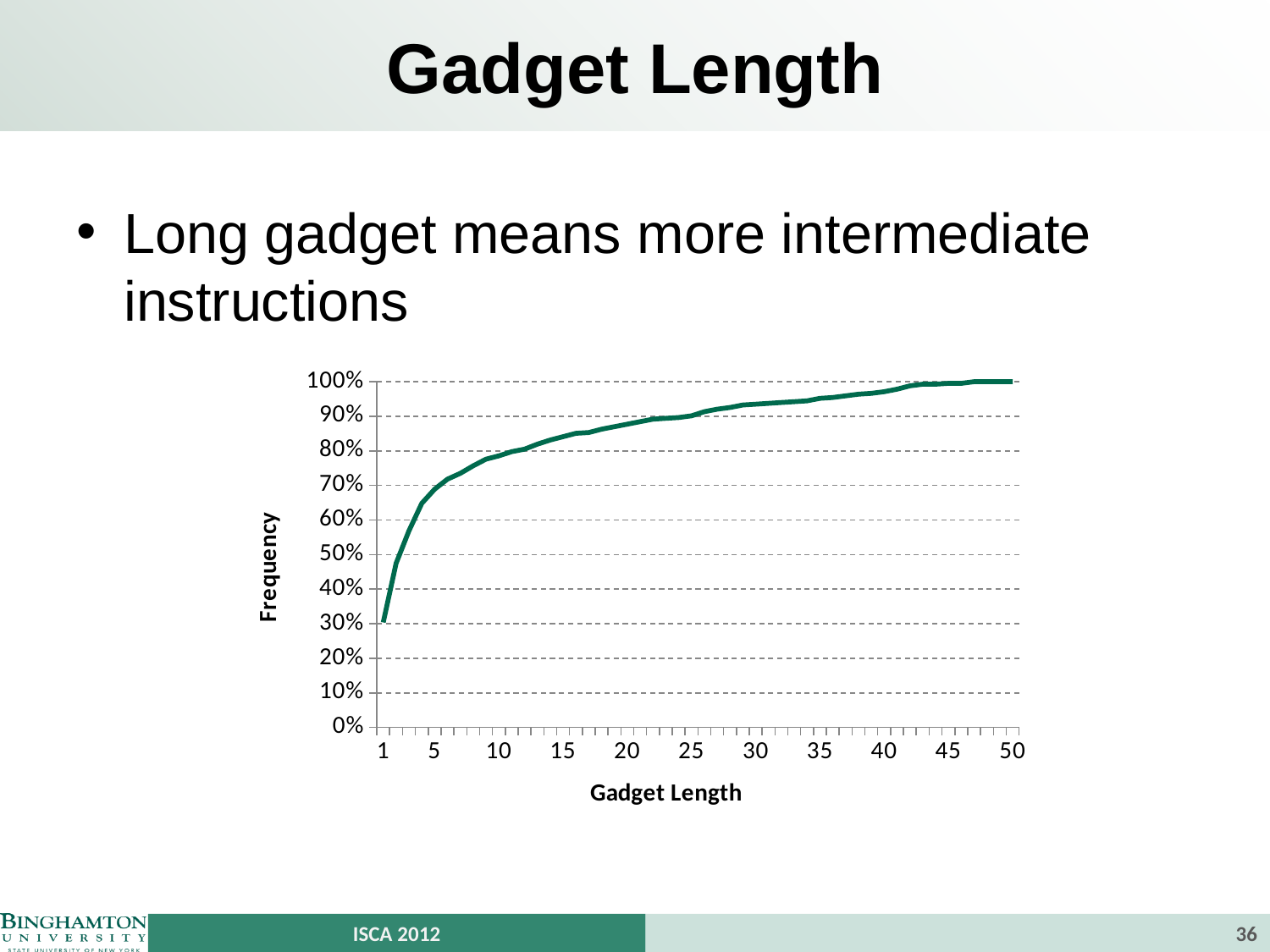
Is the frequency at gadget length 30 greater or less than 90%? greater Is the frequency at gadget length 10 greater or less than 70%? greater Is the frequency at gadget length 15 greater or less than 90%? less What is the label of the y axis of the chart? Frequency What is the label of the x axis of the chart? Gadget Length What kind of chart is shown on the slide? line chart Does the frequency rise or fall as gadget length increases along the x axis? rise Which has the higher frequency, gadget length 5 or gadget length 25? gadget length 25